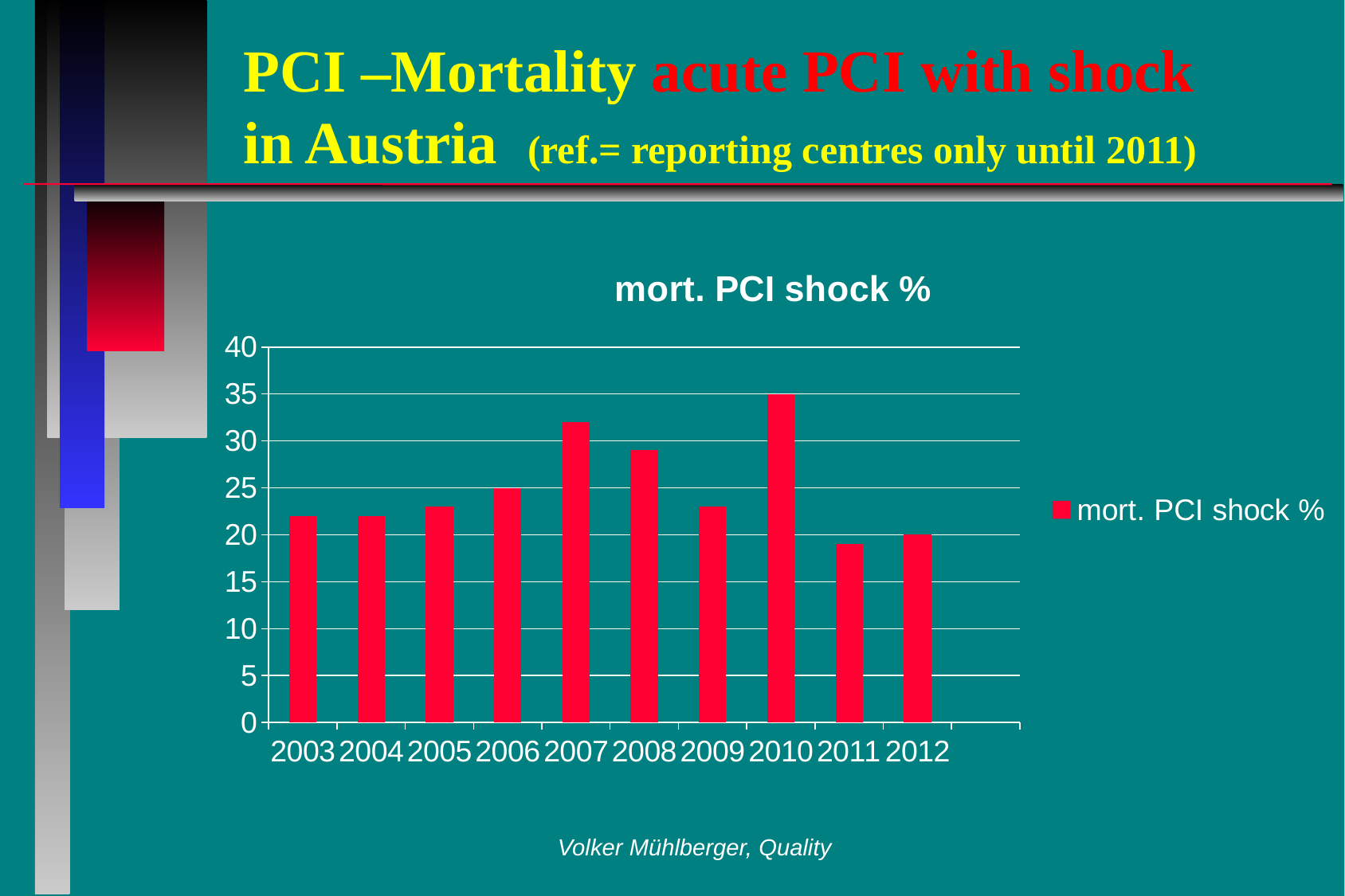
Is the value for 2009 greater or less than 25? less What is the title of the chart? mort. PCI shock % Is the value for 2007 greater or less than 30? greater What colour are the bars in the chart? red How many years are shown on the x axis? 10 Which is larger, the value for 2003 or the value for 2011? 2003 Is the value for 2011 greater or less than 20? less Which is larger, the value for 2007 or the value for 2008? 2007 How many series does the legend list? 1 Which year has the highest mort. PCI shock % value? 2010 What kind of chart is shown on the slide? bar chart